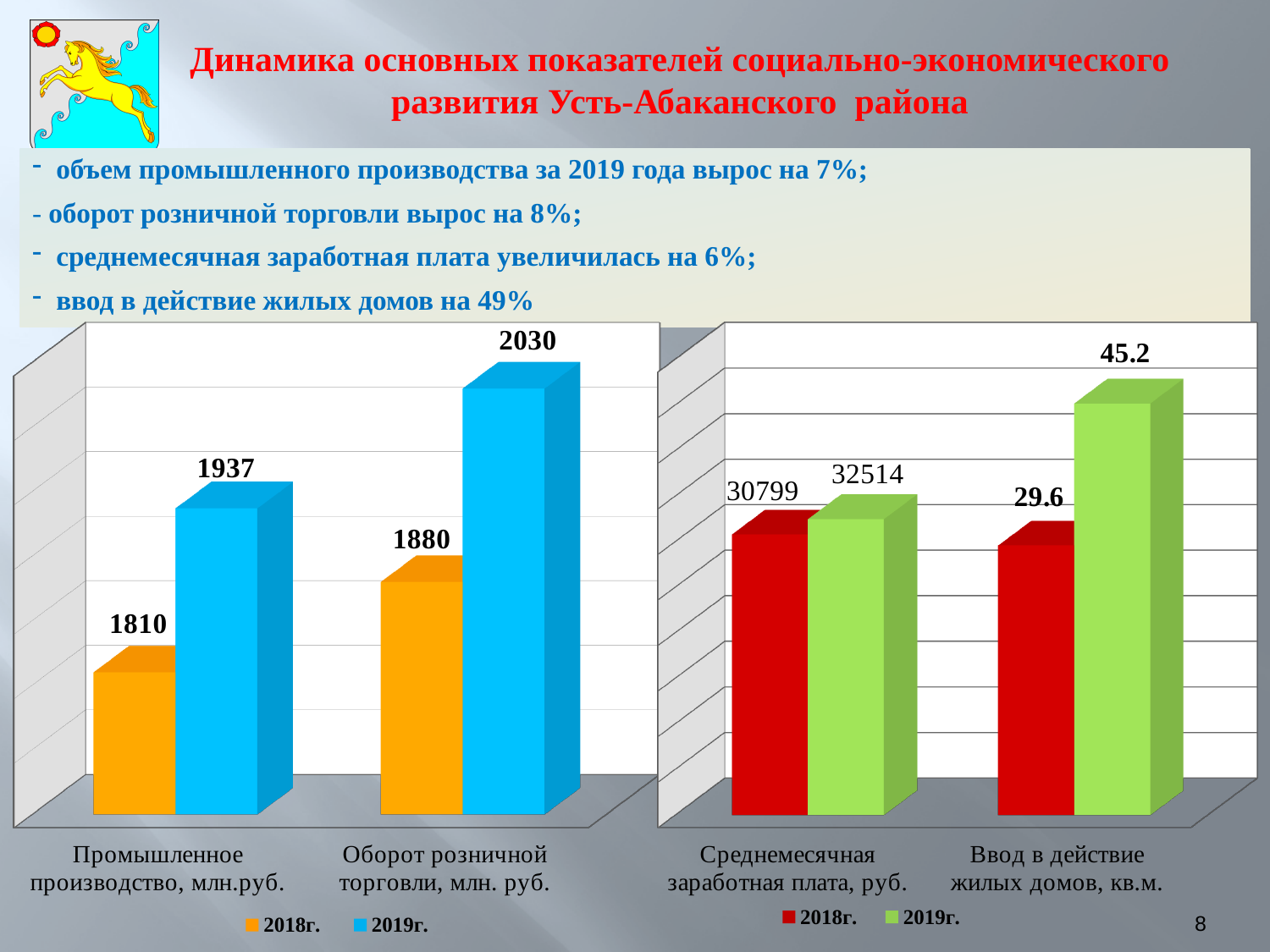
In the left chart, which bar is the lowest? Промышленное производство, 2018г. In the left chart, what is the difference between the 2019г. and 2018г. values for Промышленное производство? 127 In the right chart, what is the difference between the 2019г. and 2018г. values for Среднемесячная заработная плата? 1715 What kind of chart is the left chart? Bar chart In the left chart, which bar is the highest? Оборот розничной торговли, 2019г. In the right chart, what is the value for Среднемесячная заработная плата in 2019г.? 32514 In the left chart, what is the value for Оборот розничной торговли in 2019г.? 2030 How many series does the legend of the right chart list? 2 In the left chart, what is the difference between the 2019г. and 2018г. values for Оборот розничной торговли? 150 In the right chart, what is the value for Ввод в действие жилых домов in 2018г.? 29.6 In the right chart, which is larger for Ввод в действие жилых домов: the 2018г. value or the 2019г. value? 2019г. In the left chart, what is the value for Промышленное производство in 2018г.? 1810